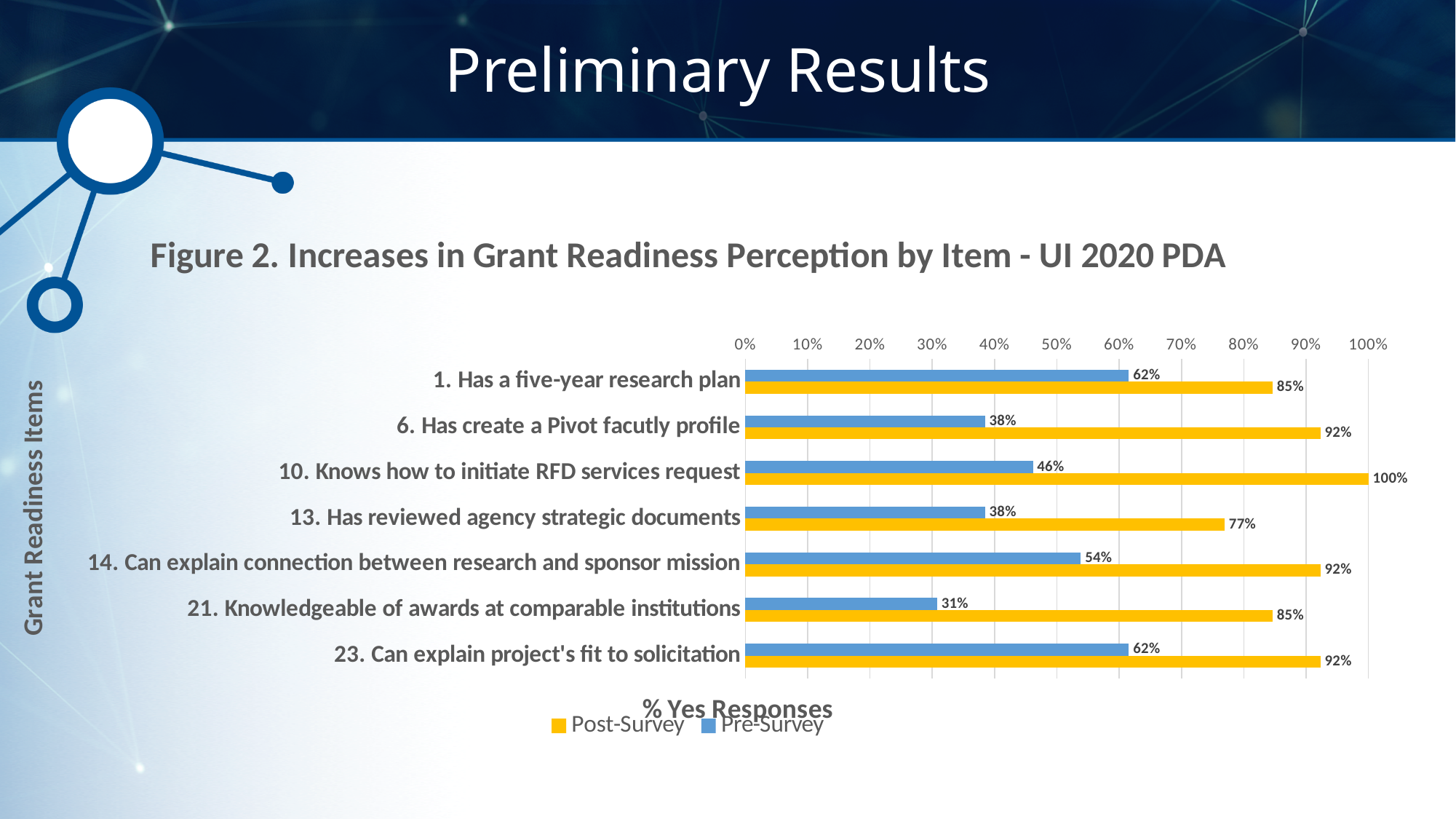
Which item has the highest Post-Survey value? 10. Knows how to initiate RFD services request What is the Post-Survey value for "10. Knows how to initiate RFD services request"? 100% How many series does the legend list? 2 What is the Post-Survey value for "13. Has reviewed agency strategic documents"? 77% What is the Pre-Survey value for "21. Knowledgeable of awards at comparable institutions"? 31% Which is larger: the Pre-Survey value for "14. Can explain connection between research and sponsor mission" or the Pre-Survey value for "10. Knows how to initiate RFD services request"? 14. Can explain connection between research and sponsor mission Which colour represents the Post-Survey series? Yellow What kind of chart is shown on the slide? Bar chart How many grant readiness items are shown on the chart? 7 What is the Pre-Survey value for "1. Has a five-year research plan"? 62% Which item has the lowest Pre-Survey value? 21. Knowledgeable of awards at comparable institutions What is the difference between the Post-Survey and Pre-Survey values for "6. Has create a Pivot facutly profile"? 54%